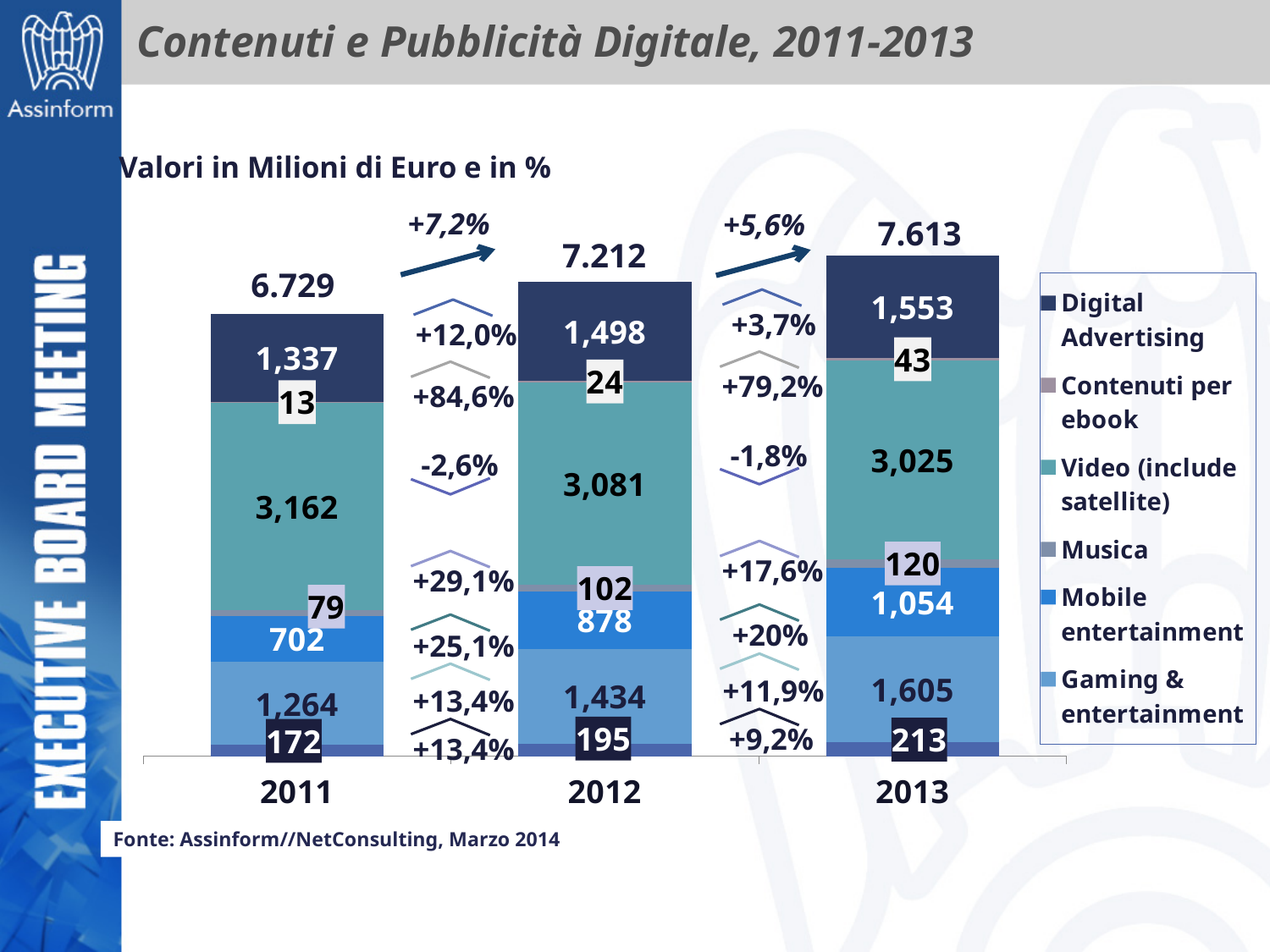
Which series has the smallest value in 2011? Contenuti per ebook What is the difference between Gaming & entertainment in 2013 and in 2011? 341 What is the value for Contenuti per ebook in 2013? 43 Does the value for Digital Advertising rise or fall from 2011 to 2013? rise Which year has the highest total? 2013 How many series does the legend list? 6 What is the total of the stacked bar for 2013? 7.613 In 2012, which is larger: Musica or Contenuti per ebook? Musica What is the value for Digital Advertising in 2013? 1,553 What is the value for Mobile entertainment in 2011? 702 What kind of chart is shown on the slide? stacked bar chart What is the value for Video (include satellite) in 2012? 3,081